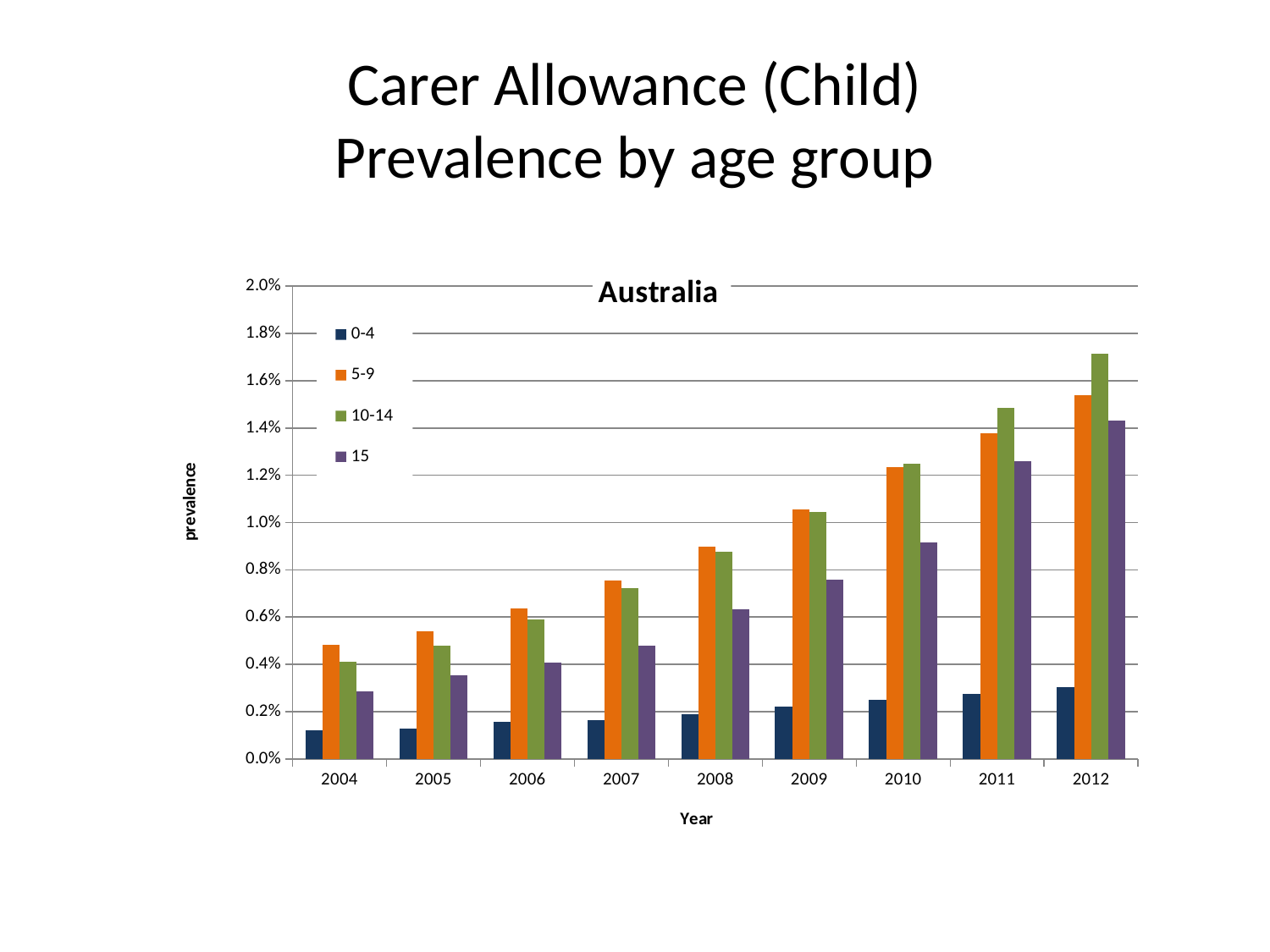
How many age-group series does the legend list? 4 For the 15 age group, which year has the larger prevalence: 2010 or 2011? 2011 Is the prevalence for the 15 age group in 2004 greater or less than 0.4%? less Is the prevalence for the 5-9 age group in 2008 greater or less than 0.8%? greater What kind of chart is shown on the slide? bar chart Is the prevalence for the 10-14 age group in 2012 greater or less than 1.6%? greater Which age group has the lowest prevalence in every year shown? 0-4 Does the prevalence for the 5-9 age group rise or fall from 2004 to 2012? rise What is the title shown inside the chart area? Australia In 2004, which has the larger prevalence: the 5-9 age group or the 10-14 age group? 5-9 How many years are shown along the x axis? 9 In 2012, which age group has the highest prevalence? 10-14